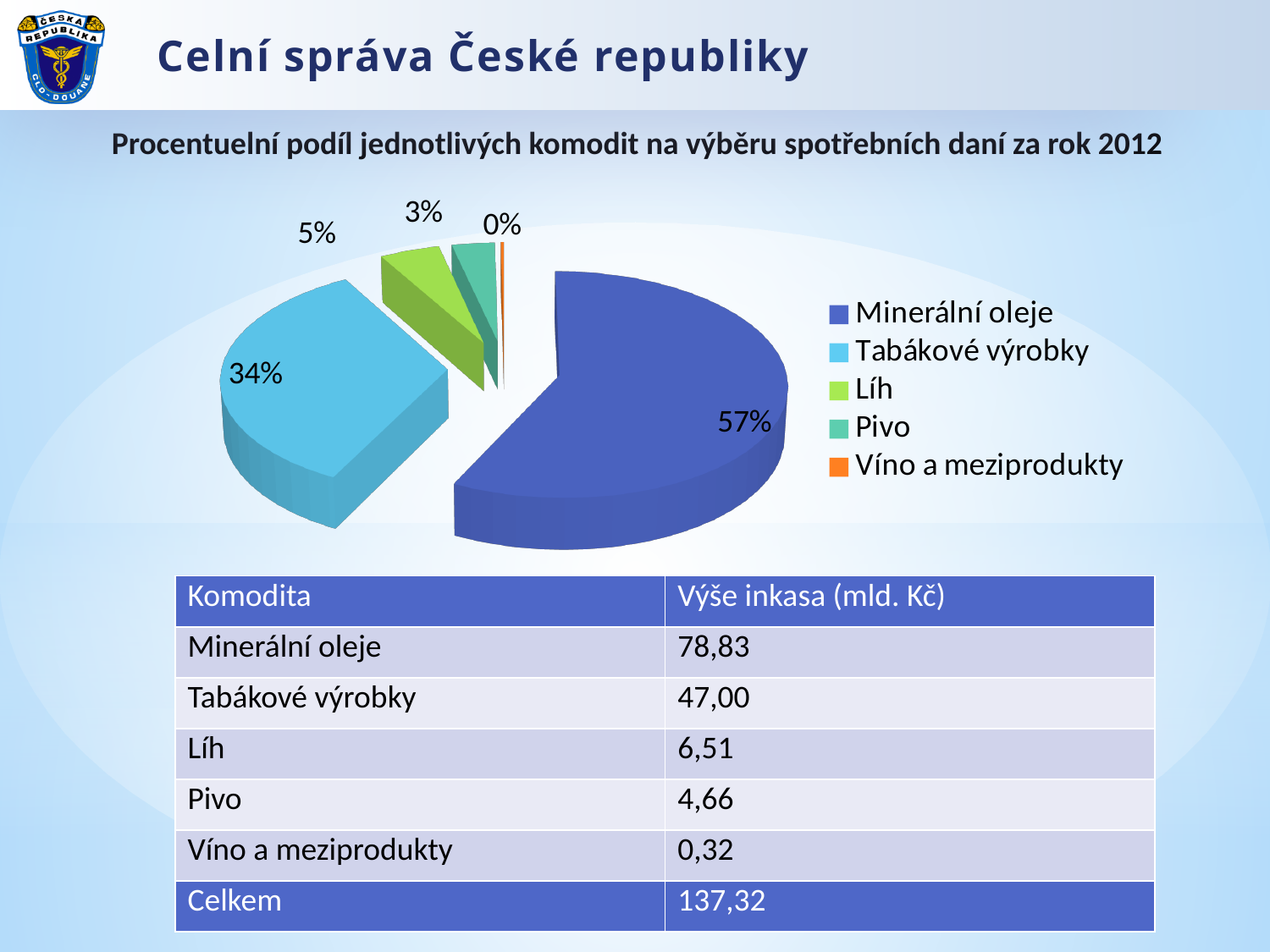
What share of the pie does Líh have? 5% What share of the pie does Minerální oleje have? 57% Which slice is larger, Líh or Pivo? Líh What share of the pie does Tabákové výrobky have? 34% How many categories does the legend of the pie chart list? 5 Which category has the smallest slice of the pie? Víno a meziprodukty What is the difference in percentage points between the Minerální oleje slice and the Tabákové výrobky slice? 23 What colour is the Tabákové výrobky slice in the pie chart? light blue What kind of chart is shown on the slide? pie chart Which category has the largest slice of the pie? Minerální oleje